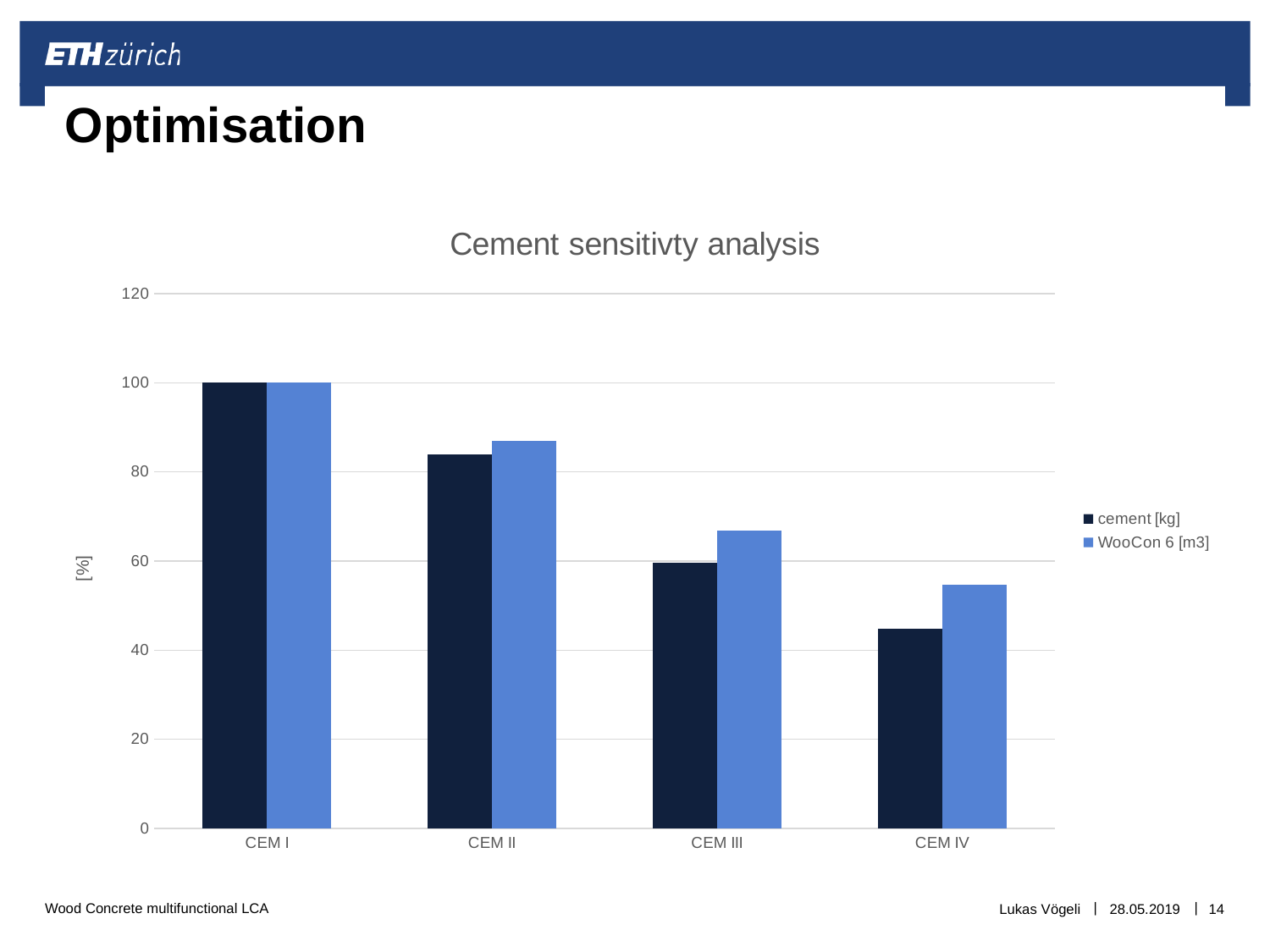
Is the value for WooCon 6 [m3] at CEM IV greater or less than 60? less How many categories are shown on the x axis? 4 At CEM IV, which series has the larger value, cement [kg] or WooCon 6 [m3]? WooCon 6 [m3] Which category has the highest value for WooCon 6 [m3]? CEM I What type of chart is shown on the slide? bar chart What is the value for cement [kg] at CEM I? 100 What is the title of the chart? Cement sensitivty analysis Do the values for cement [kg] rise or fall from CEM I to CEM IV? fall Is the value for cement [kg] at CEM II greater or less than 80? greater How many series does the legend list? 2 Which category has the lowest value for cement [kg]? CEM IV What is the value for WooCon 6 [m3] at CEM I? 100